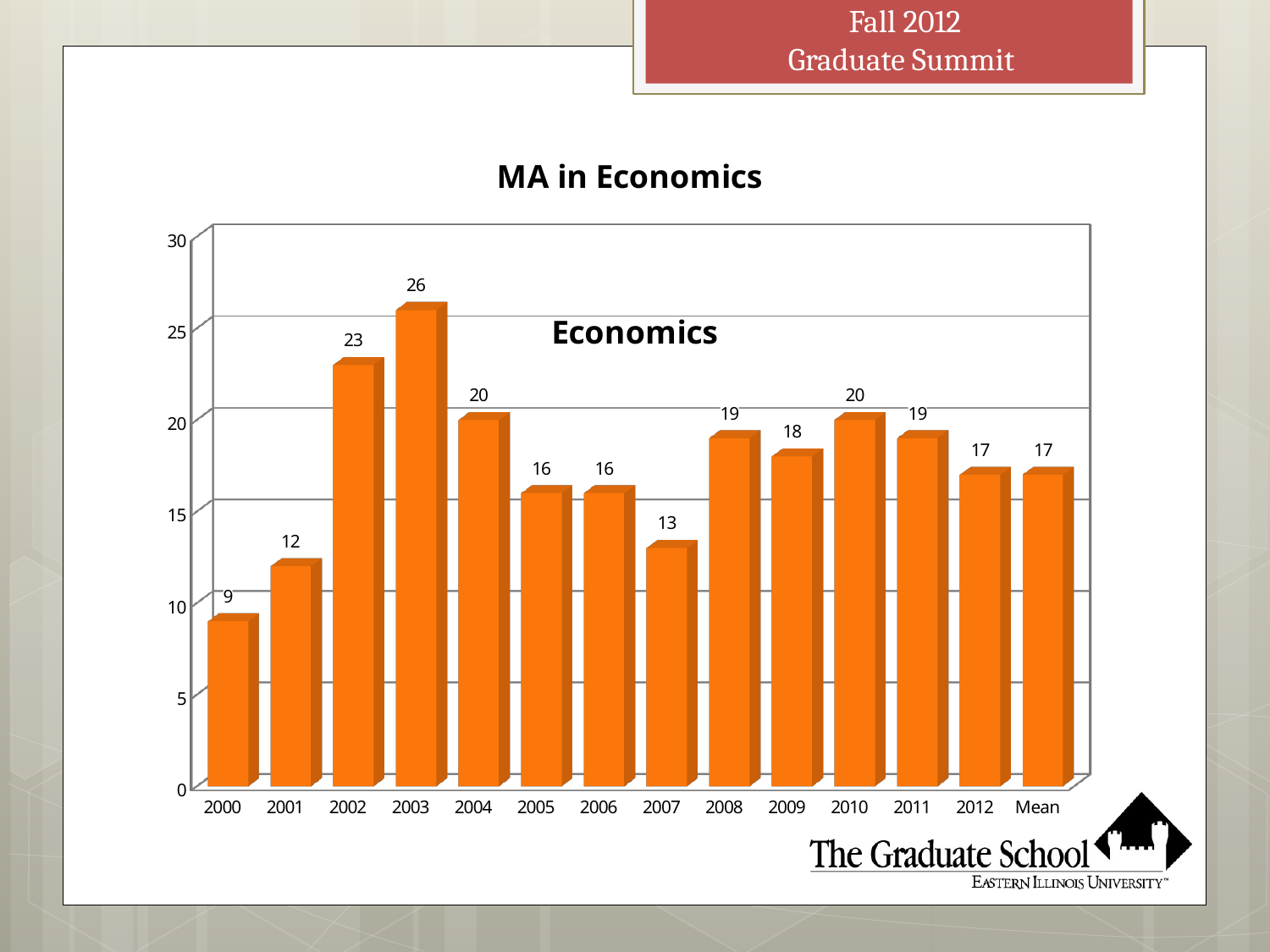
Do the values rise or fall from 2000 to 2003? rise What kind of chart is this? bar chart What is the title of the chart? MA in Economics What is the difference between the values for 2003 and 2007? 13 What is the value for 2003? 26 How many categories are shown on the x axis? 14 Which is larger, the value for 2002 or the value for 2008? 2002 What is the value for 2000? 9 What is the value shown for Mean? 17 Is the value for 2010 greater or less than 15? greater Which category has the lowest value? 2000 Which year has the highest value? 2003